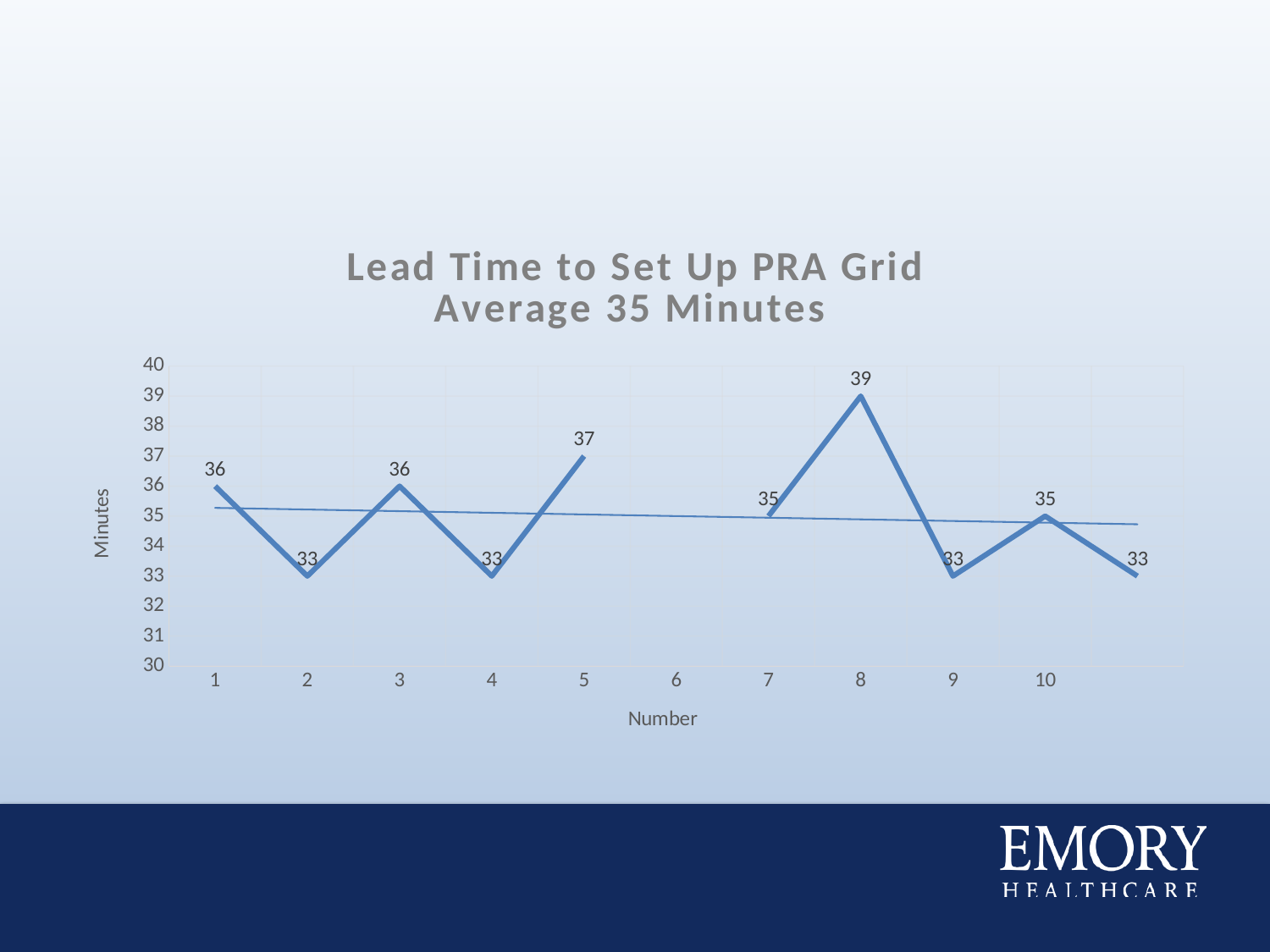
What is the value in minutes at Number 8? 39 What kind of chart is shown on the slide? line chart Is the value at Number 8 greater or less than 38? greater Which has the larger value, Number 3 or Number 5? Number 5 What is the value in minutes at Number 5? 37 What is the value in minutes at Number 1? 36 What is the difference between the values at Number 8 and Number 9? 6 What is the value in minutes at Number 10? 35 What is the difference between the values at Number 5 and Number 4? 4 What is the title of the vertical axis? Minutes What is the lowest lead time value shown on the chart? 33 At which Number is the lead time highest? 8